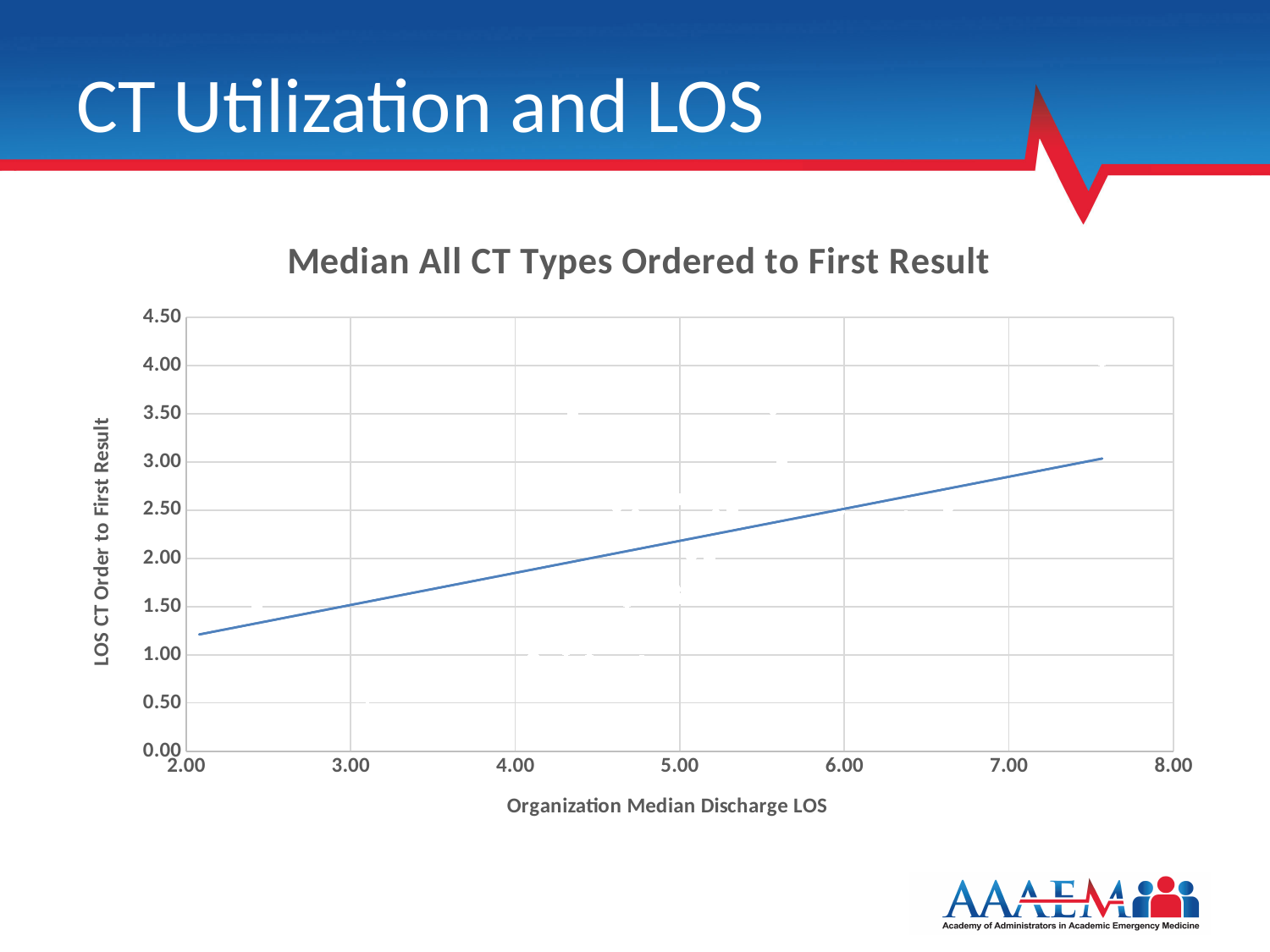
What is the title of the chart? Median All CT Types Ordered to First Result Is the value of the line at an Organization Median Discharge LOS of 4.00 greater or less than 2.00? less Is the value of the line at its right-hand end greater or less than 3.50? less Is the value of the line at its left-hand end greater or less than 1.50? less What is the label of the horizontal axis? Organization Median Discharge LOS What kind of chart is shown on the slide? line chart Does the line rise or fall as Organization Median Discharge LOS increases? rises